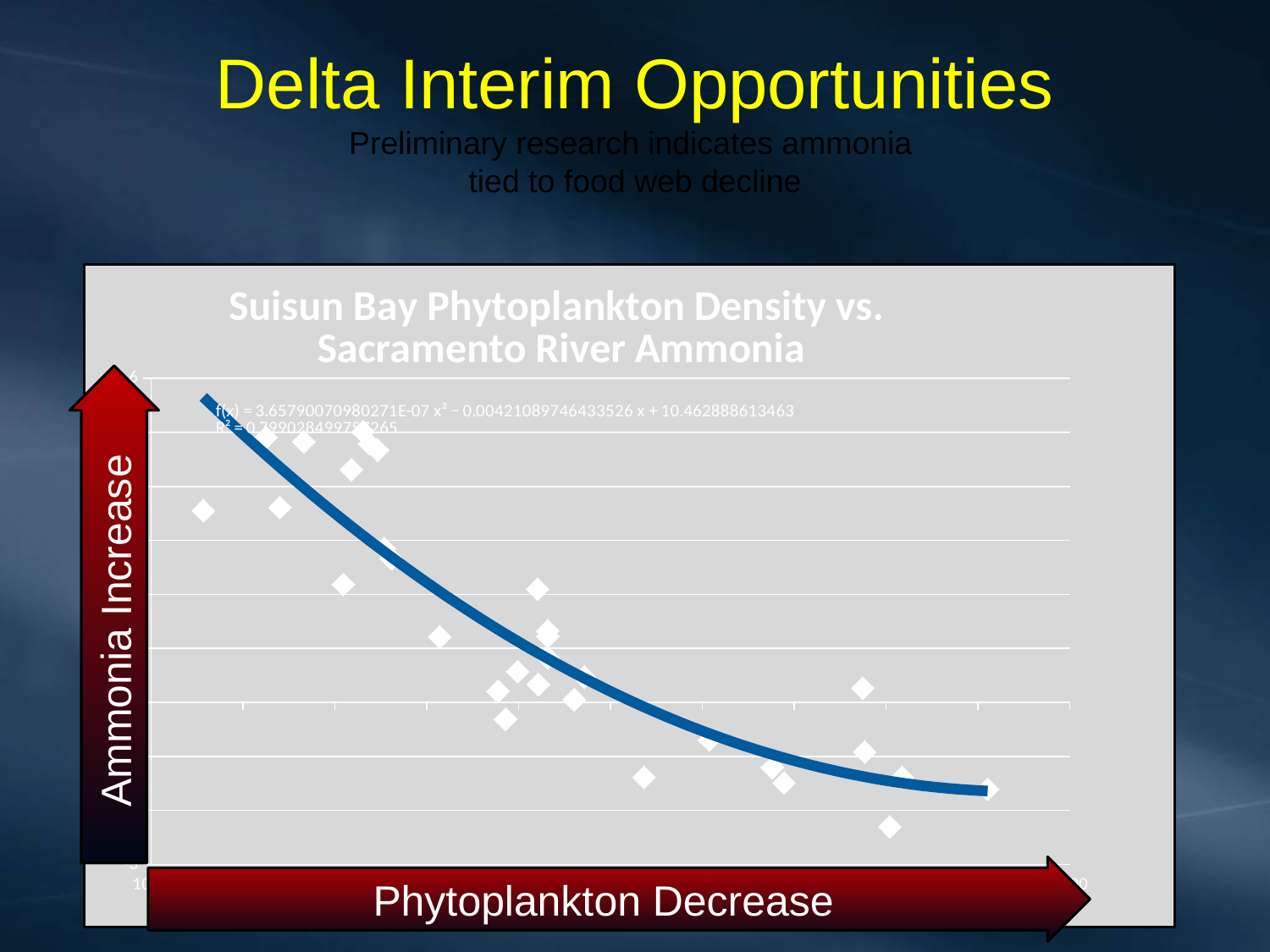
What is the constant term in the trendline equation f(x) shown on the chart? 10.462888613463 What is the title of the chart? Suisun Bay Phytoplankton Density vs. Sacramento River Ammonia What colour is the fitted trendline drawn through the data points? blue Do the plotted values rise or fall as you move from left to right along the x axis? fall What kind of chart is shown on the slide? scatter chart